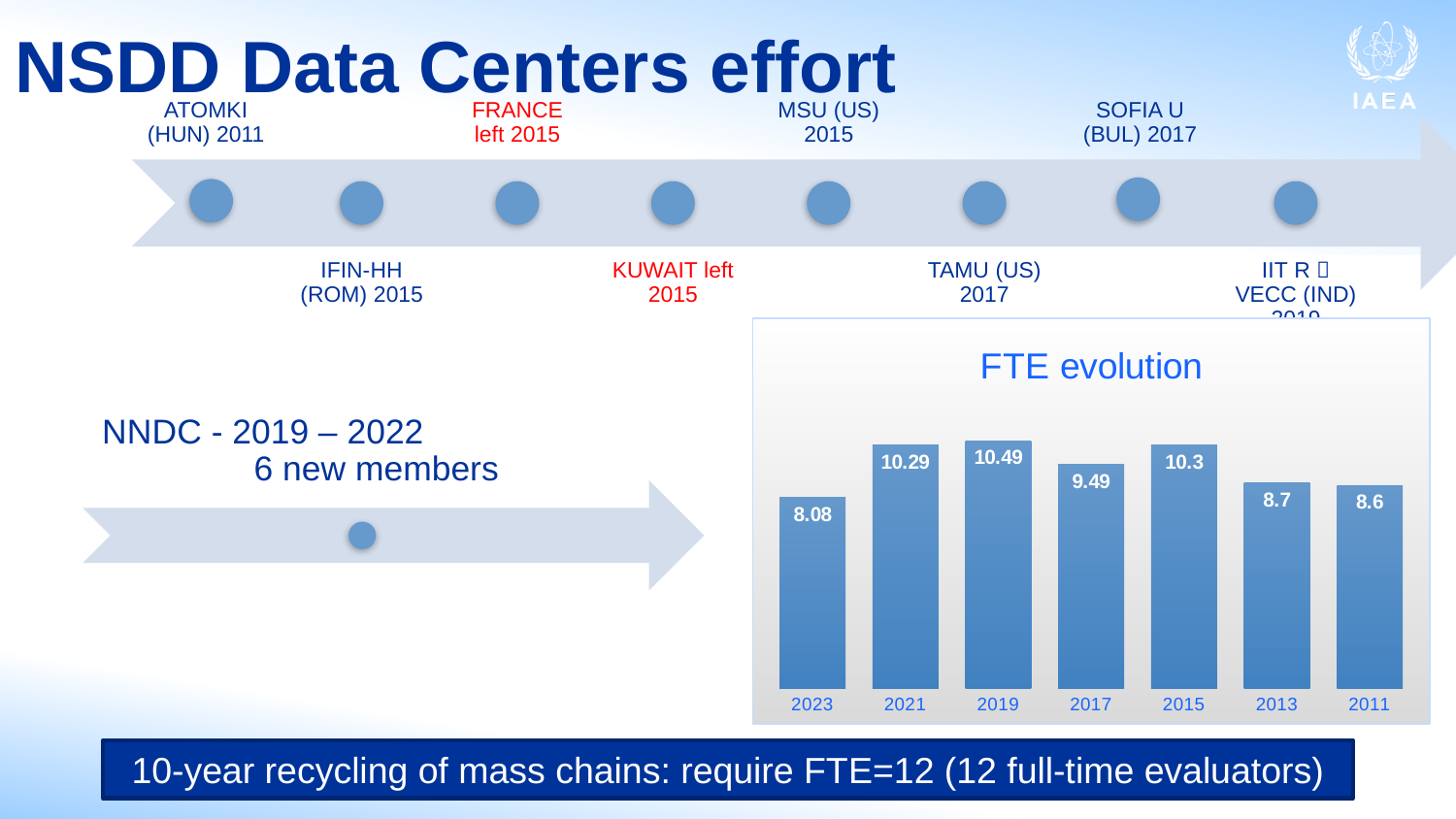
What kind of chart is the FTE evolution chart? bar chart What is the value for 2019 in the FTE evolution chart? 10.49 How many years are shown in the FTE evolution chart? 7 What is the value for 2023 in the FTE evolution chart? 8.08 What is the difference between the values for 2019 and 2023 in the FTE evolution chart? 2.41 What is the value for 2015 in the FTE evolution chart? 10.3 What is the title of the chart on the slide? FTE evolution In the FTE evolution chart, which is larger: the value for 2021 or the value for 2017? 2021 What is the difference between the values for 2015 and 2013 in the FTE evolution chart? 1.6 Which year has the highest value in the FTE evolution chart? 2019 Which year has the lowest value in the FTE evolution chart? 2023 What is the value for 2011 in the FTE evolution chart? 8.6